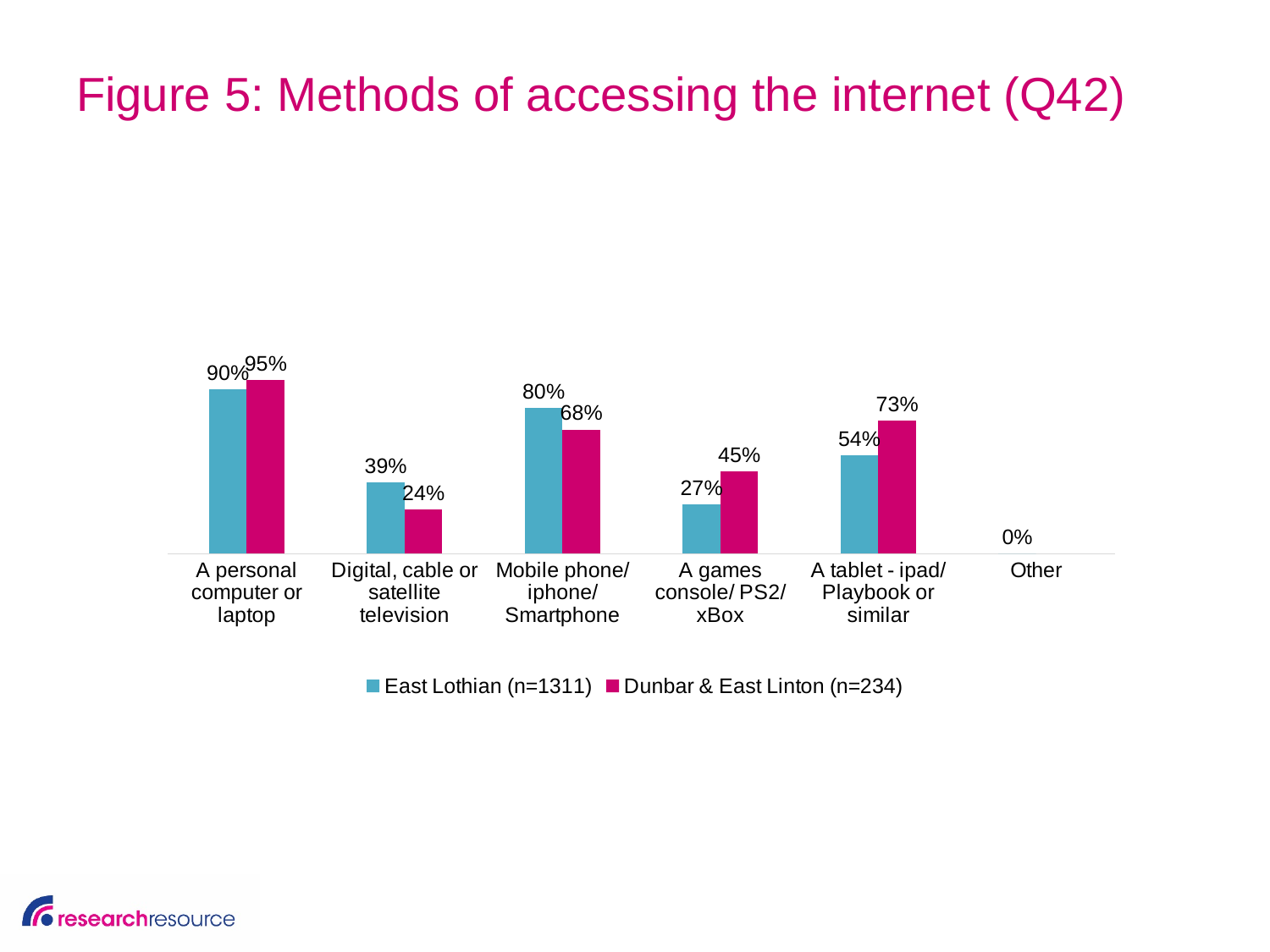
How many categories of internet access method are shown on the x axis? 6 What is the value for Dunbar & East Linton for a tablet - ipad/Playbook or similar? 73% What is the difference between the Dunbar & East Linton and East Lothian values for a games console/PS2/xBox? 18% Which is larger for digital, cable or satellite television: the East Lothian value or the Dunbar & East Linton value? East Lothian How many series does the legend list? 2 What kind of chart is shown on the slide? Bar chart Which method of accessing the internet has the highest value for Dunbar & East Linton? A personal computer or laptop What is the sample size (n) for the Dunbar & East Linton series shown in the legend? 234 What percentage of East Lothian respondents access the internet via a personal computer or laptop? 90% Among the methods with labelled non-zero values, which has the lowest value for Dunbar & East Linton? Digital, cable or satellite television What is the difference between the East Lothian and Dunbar & East Linton values for mobile phone/iphone/Smartphone? 12% What is the value for East Lothian for a games console/PS2/xBox? 27%